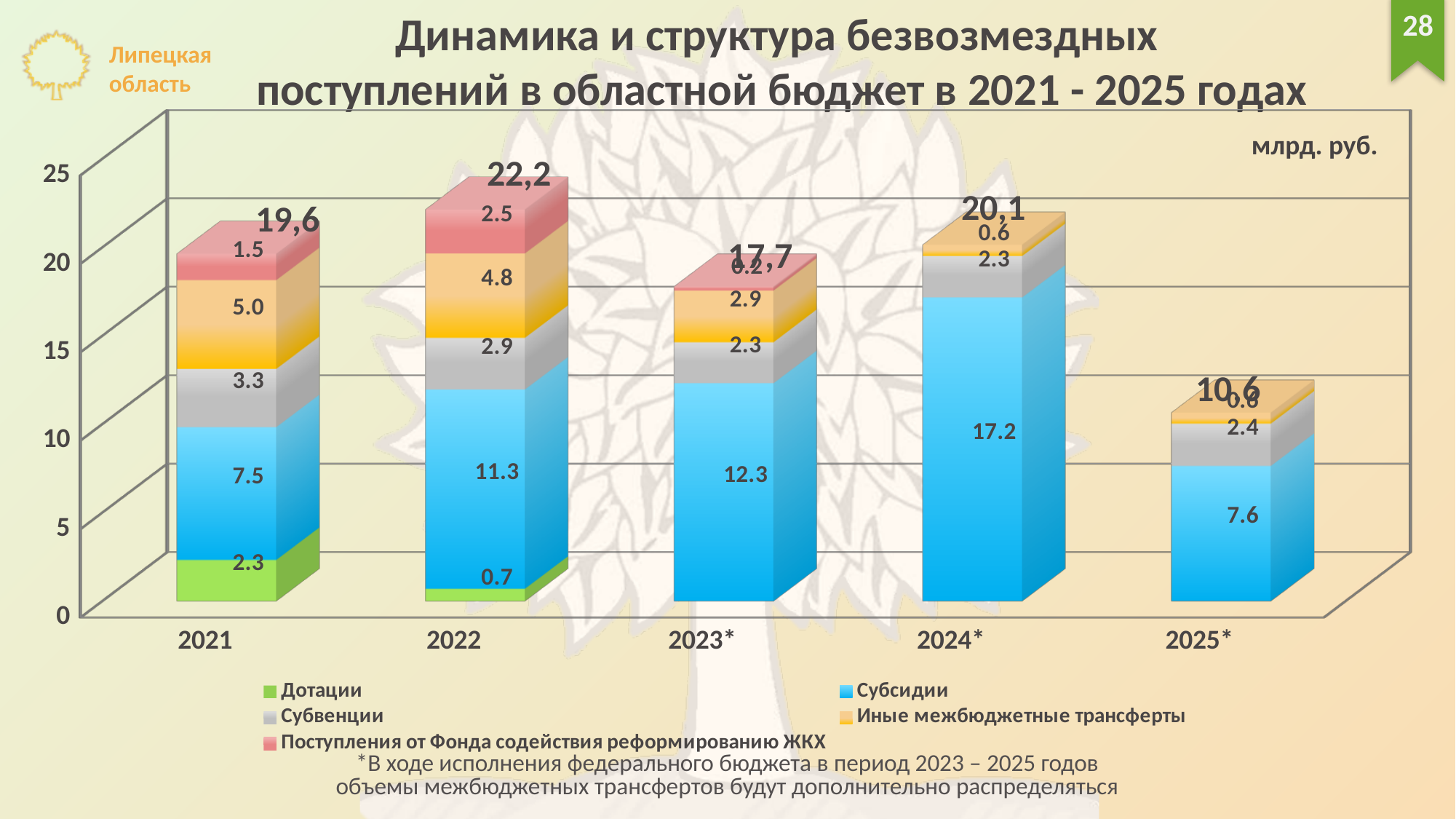
What kind of chart is shown on the slide? Stacked bar chart Which is larger, the Субвенции value for 2021 or for 2022? 2021 What is the value of the Субсидии segment for 2024*? 17.2 Which year has the lowest total value? 2025* What is the total value shown above the bar for 2022? 22,2 How many series does the legend list? 5 What is the value of the Иные межбюджетные трансферты segment for 2022? 4.8 What is the value of the Дотации segment for 2021? 2.3 How many years are shown on the x axis? 5 In what unit are the values on the chart expressed? млрд. руб. What is the difference between the Субсидии values for 2023* and 2021? 4.8 Which year has the highest total value? 2022